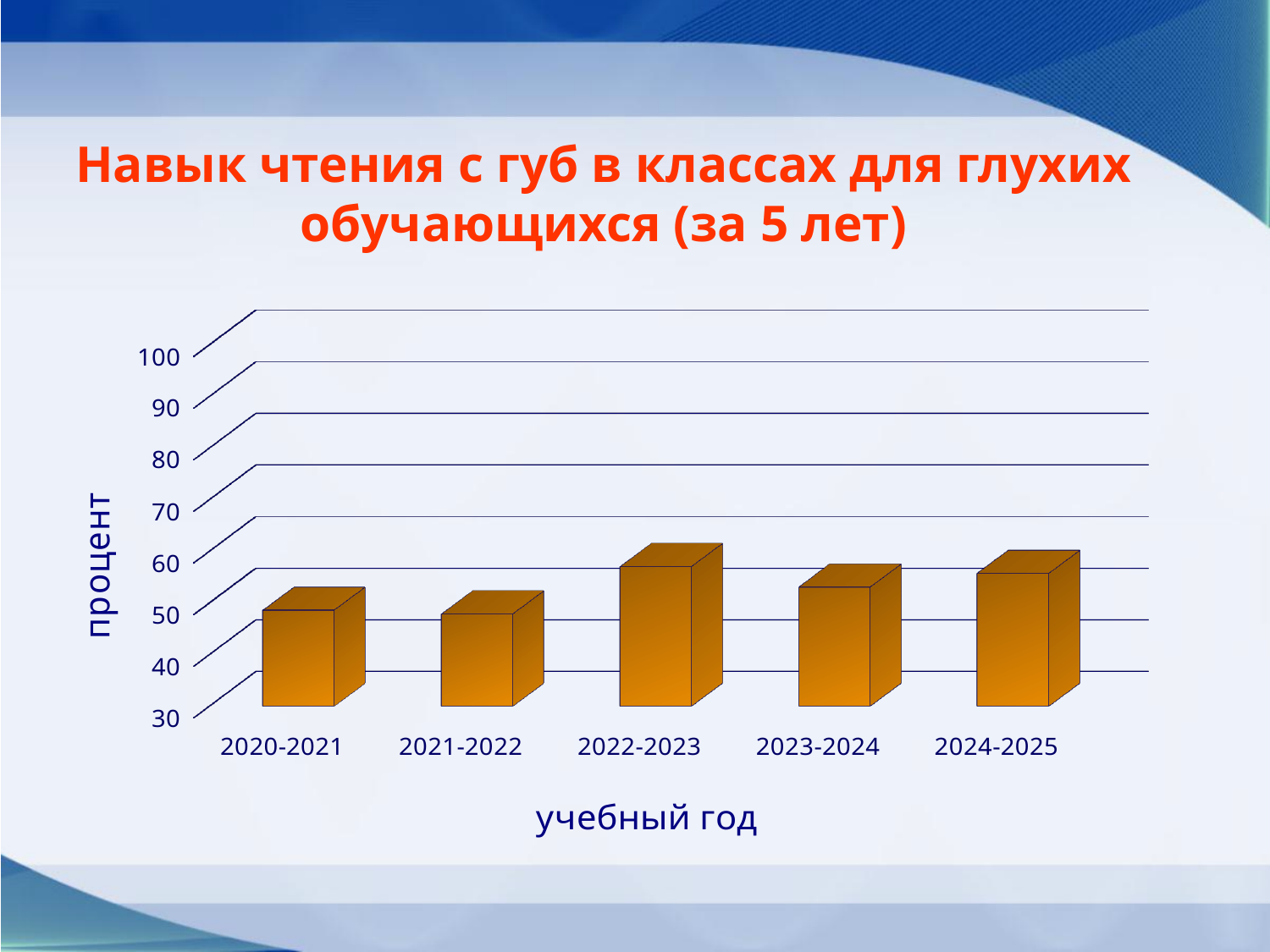
What kind of chart is shown on the slide? bar chart Does the value rise or fall from 2021-2022 to 2022-2023? rise Which is larger, the value for 2022-2023 or the value for 2021-2022? 2022-2023 What is the label of the vertical axis of the chart? процент Is the value for 2021-2022 greater or less than 60? less What is the label of the horizontal axis of the chart? учебный год Which is larger, the value for 2023-2024 or the value for 2020-2021? 2023-2024 How many academic years are shown on the x axis of the chart? 5 Is the value for 2024-2025 greater or less than 40? greater Is the value for 2020-2021 greater or less than 70? less Which academic year has the highest value in the chart? 2022-2023